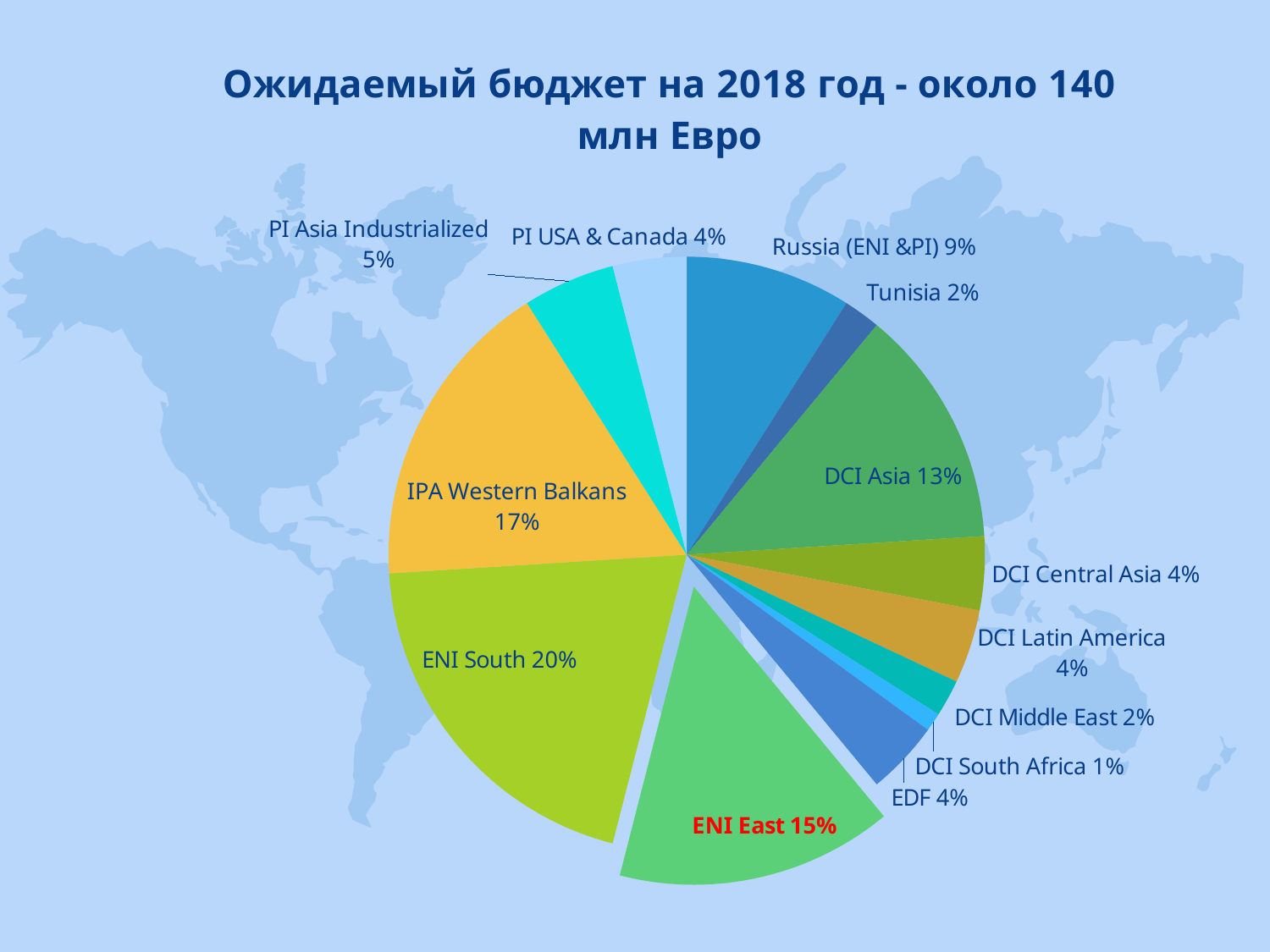
Which category has the largest slice of the pie? ENI South What share of the budget does Russia (ENI &PI) have? 9% Which category label is shown in red text on the chart? ENI East 15% How many categories are shown in the pie chart? 13 What kind of chart is shown on the slide? pie chart What share of the budget does ENI South have? 20% What share of the budget does IPA Western Balkans have? 17% What is the difference between the shares of ENI South and ENI East? 5% Which is larger, the share for IPA Western Balkans or the share for DCI Asia? IPA Western Balkans What share of the budget does DCI Asia have? 13% What is the combined share of Tunisia and DCI Middle East? 4% Which category has the smallest slice of the pie? DCI South Africa